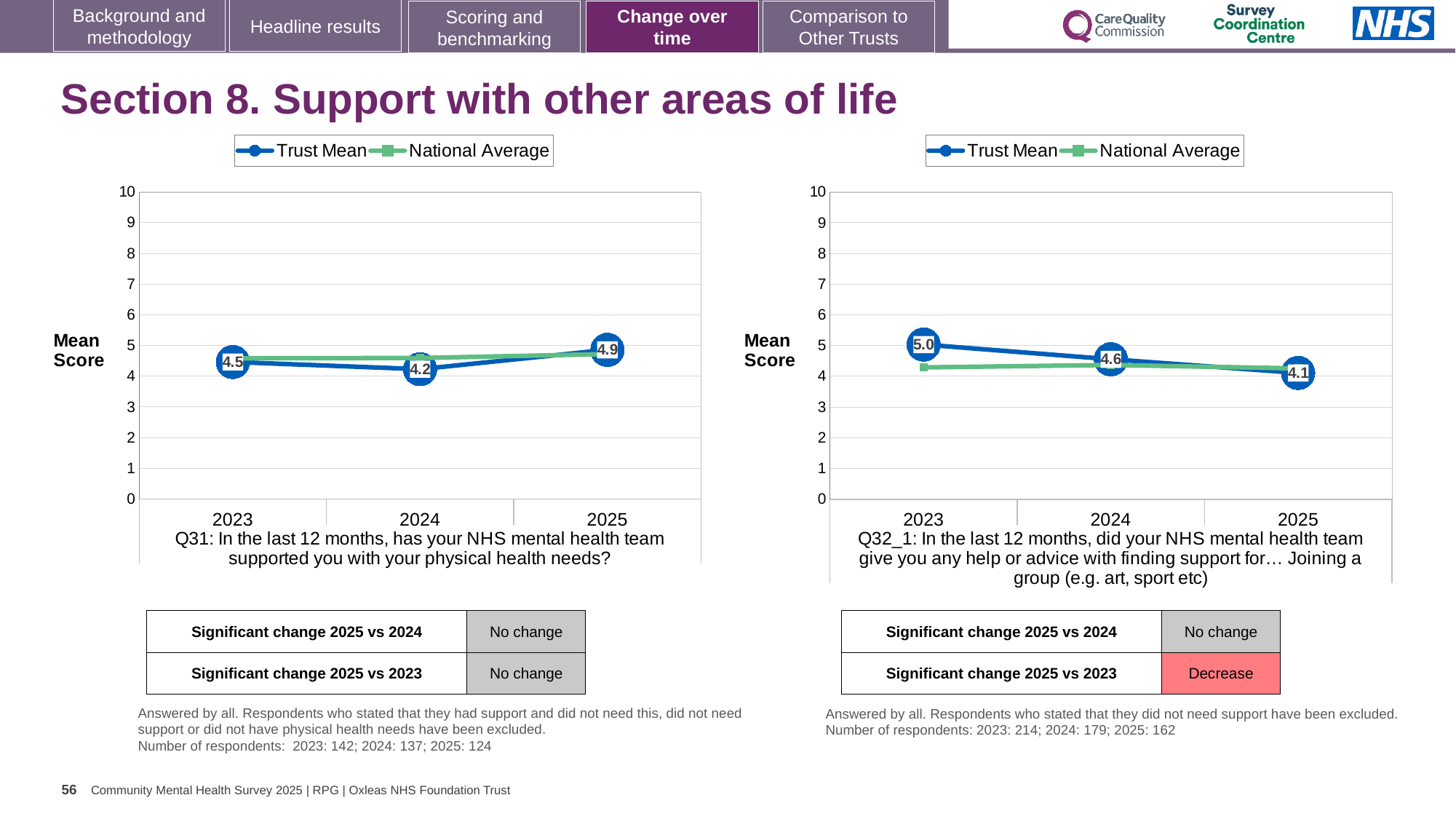
In the Q32_1 chart on the right, which year has the highest Trust Mean? 2023 In the Q32_1 chart on the right, what is the Trust Mean for 2023? 5.0 How many series does the legend of the Q31 chart on the left list? 2 In the Q31 chart on the left, what is the Trust Mean for 2025? 4.9 How many years are plotted on the x axis of the Q32_1 chart on the right? 3 In the Q32_1 chart on the right, does the Trust Mean rise or fall from 2023 to 2025? fall In the Q32_1 chart on the right, what is the difference between the Trust Mean for 2023 and 2025? 0.9 In the Q31 chart on the left, which year has the lowest Trust Mean? 2024 In the Q31 chart on the left, what is the difference between the Trust Mean for 2025 and 2024? 0.7 In the Q31 chart on the left, is the National Average for 2025 greater or less than 5? less What kind of chart is the Q31 chart on the left? line chart In the Q32_1 chart on the right, which is larger: the Trust Mean for 2024 or for 2025? 2024